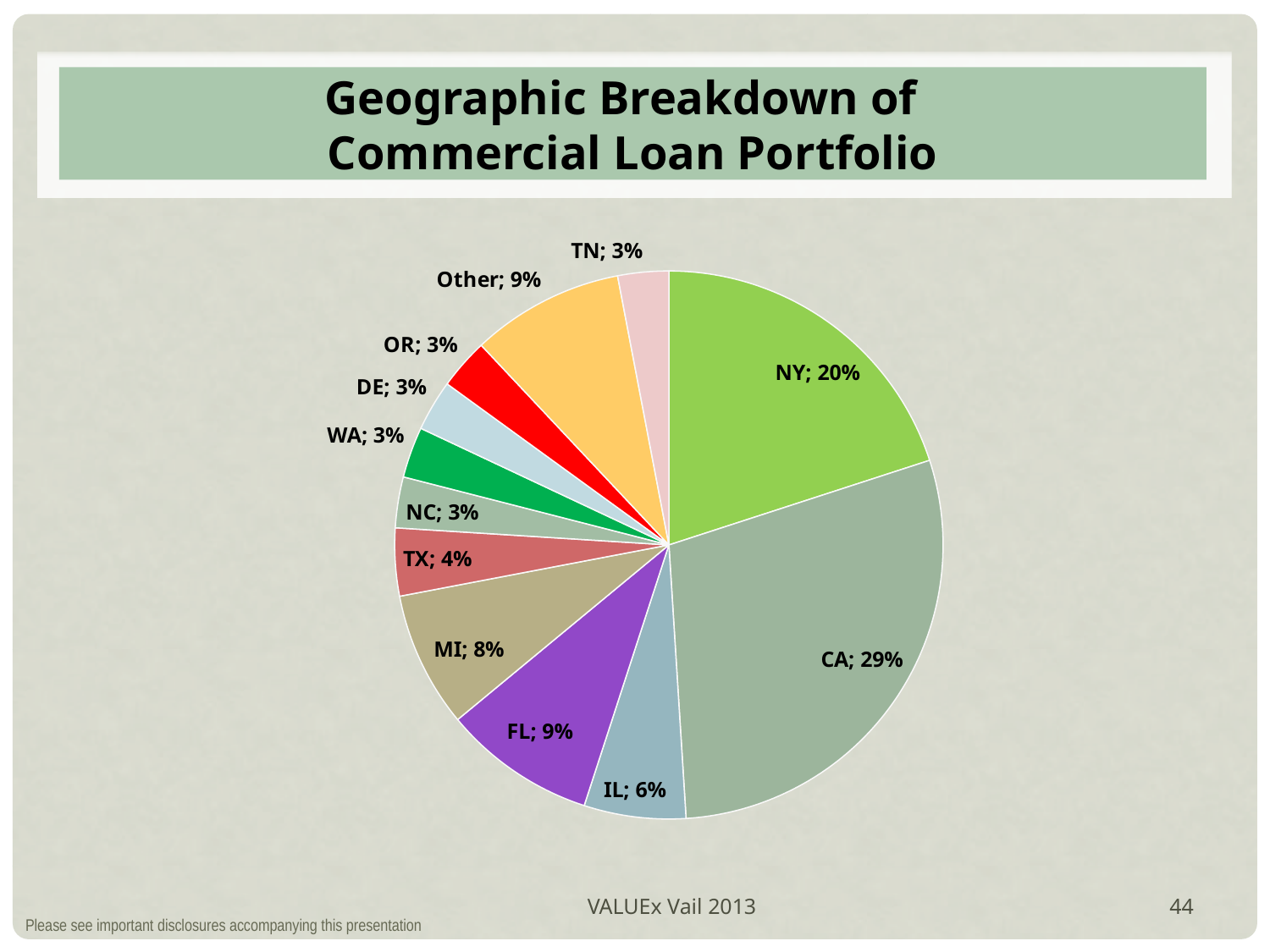
What is the combined share of FL and IL? 15% Which has a larger share of the portfolio, TX or MI? MI What kind of chart is shown on the slide? Pie chart What percentage of the portfolio does MI account for? 8% What percentage of the portfolio is labelled Other? 9% What is the title of the chart? Geographic Breakdown of Commercial Loan Portfolio Which state has the largest share of the commercial loan portfolio? CA What is the difference in percentage points between the CA and NY shares? 9 How many slices does the pie chart have? 12 What share of the commercial loan portfolio is in NY? 20% What share of the commercial loan portfolio is in CA? 29% Which has a larger share of the portfolio, FL or IL? FL